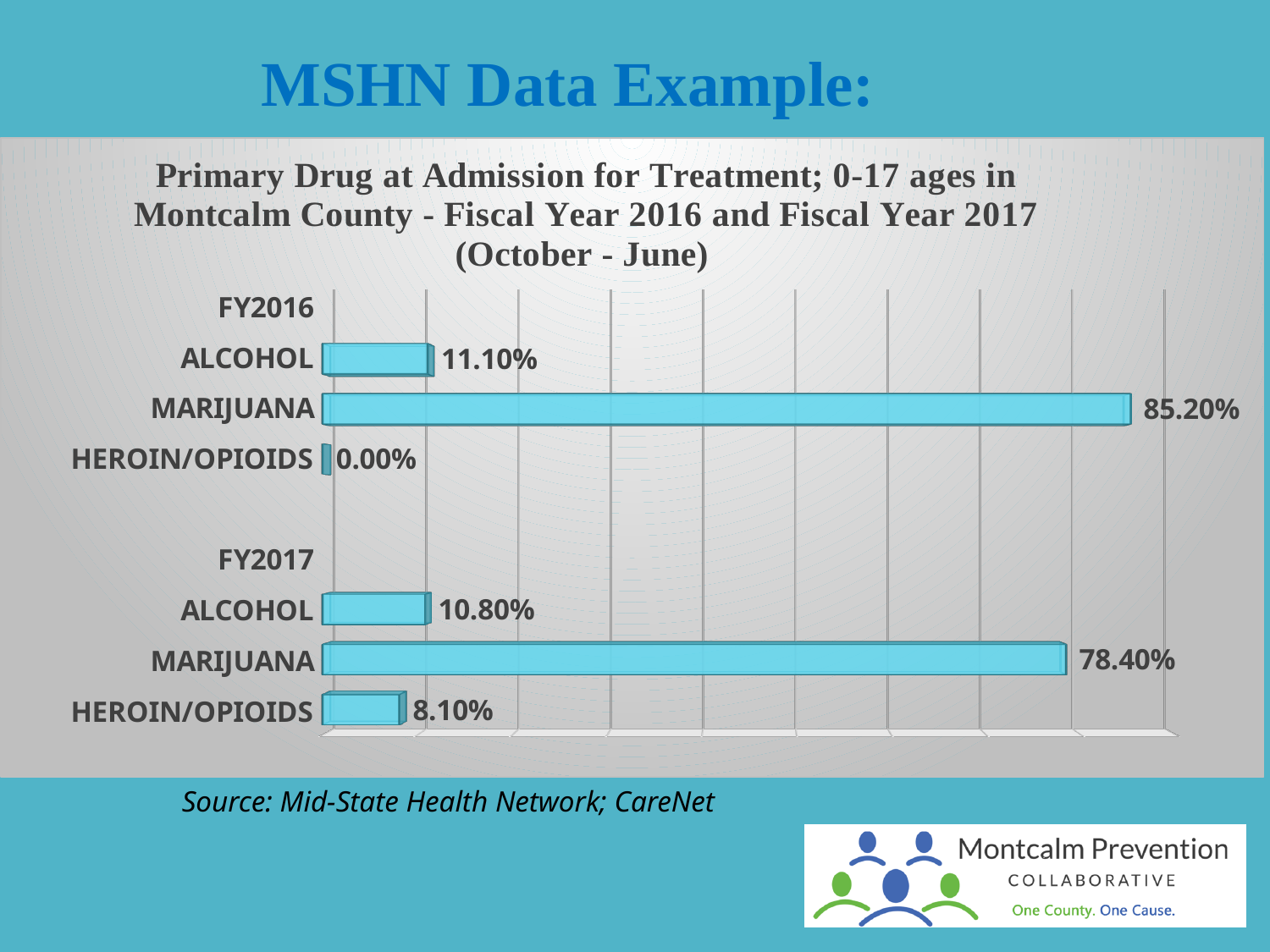
What kind of chart is shown on the slide? Bar chart What is the value for HEROIN/OPIOIDS in FY2017? 8.10% What is the difference between the MARIJUANA values for FY2016 and FY2017? 6.80% How many bars with data labels are plotted on the chart? 6 Which category has the lowest value in FY2016? HEROIN/OPIOIDS What is the difference between the ALCOHOL values for FY2016 and FY2017? 0.30% What is the source cited below the chart? Mid-State Health Network; CareNet What is the value for MARIJUANA in FY2016? 85.20% What is the value for HEROIN/OPIOIDS in FY2016? 0.00% Which category has the highest value in FY2017? MARIJUANA Which is larger, the ALCOHOL value in FY2016 or the HEROIN/OPIOIDS value in FY2017? ALCOHOL in FY2016 What is the value for ALCOHOL in FY2017? 10.80%